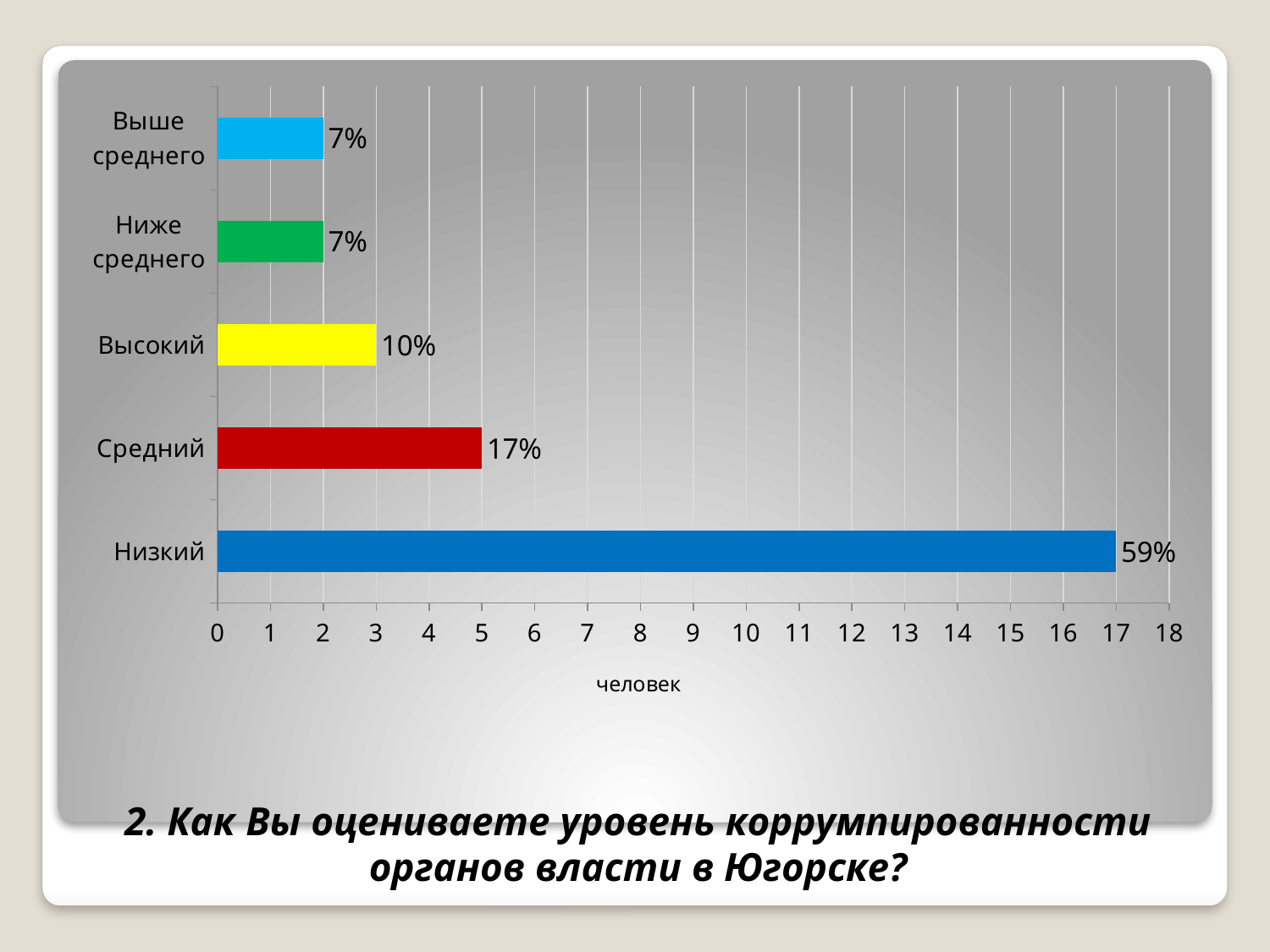
What data label is shown for the Средний bar? 17% How many categories are shown in the chart? 5 What kind of chart is shown on the slide? bar chart Is the value for Низкий greater or less than 10 on the x axis? greater Which is larger, the value for Высокий or the value for Средний? Средний What is the label of the x axis? человек What data label is shown for the Низкий bar? 59% Which category has the highest value? Низкий What data label is shown for the Высокий bar? 10% How many people (человек) does the Низкий bar reach on the x axis? 17 What is the difference in percentage points between the Низкий and Средний data labels? 42% How many people (человек) does the Средний bar reach on the x axis? 5